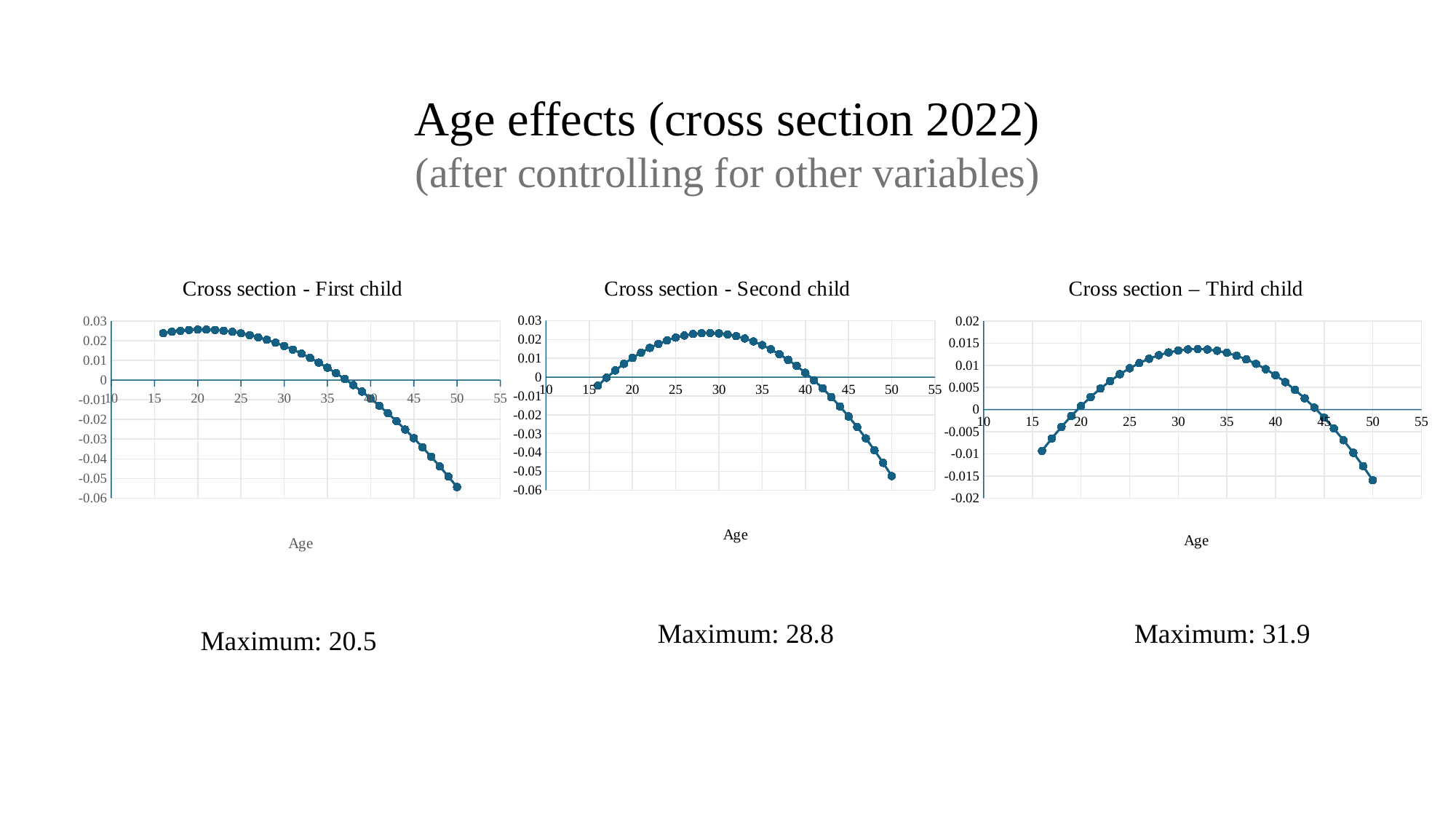
What kind of chart is the 'Cross section - First child' chart? scatter chart In the 'Cross section - First child' chart, is the value at age 50 greater or less than -0.04? less In the 'Cross section - Second child' chart, which is larger: the value at age 30 or the value at age 50? age 30 In the 'Cross section - Second child' chart, is the value at age 30 greater or less than 0.01? greater In the 'Cross section - Second child' chart, do the values rise or fall between age 40 and age 50? fall What is the x-axis label of the 'Cross section – Third child' chart? Age How many charts are shown on the slide? 3 In the 'Cross section – Third child' chart, is the value at age 50 greater or less than -0.01? less In the 'Cross section - First child' chart, at which age is the plotted value lowest? 50